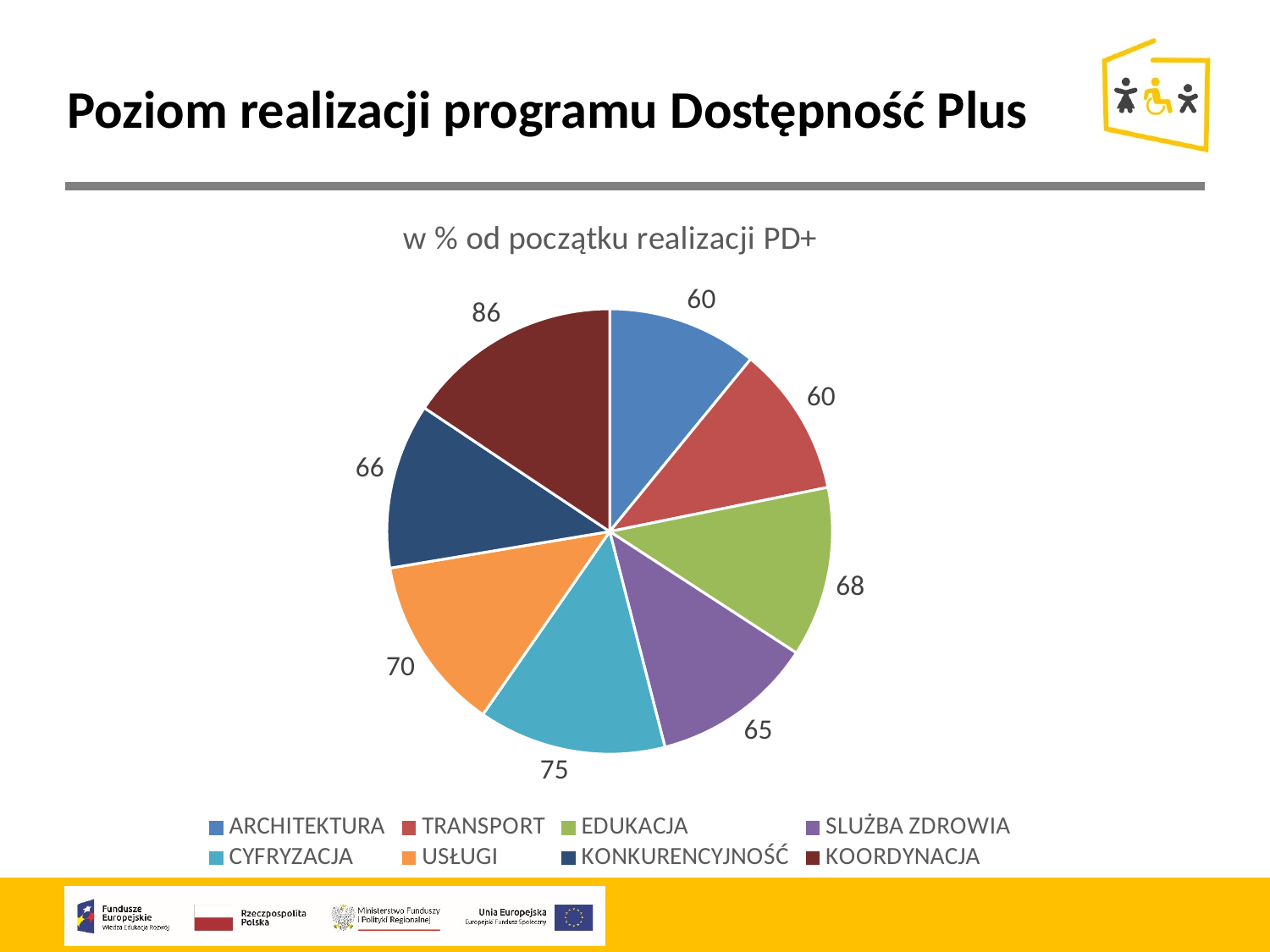
Which is larger, the value for KONKURENCYJNOŚĆ or the value for EDUKACJA? EDUKACJA What is the difference between the values for KOORDYNACJA and ARCHITEKTURA? 26 What is the value for USŁUGI in the pie chart? 70 What type of chart is shown on the slide? Pie chart What is the value for EDUKACJA in the pie chart? 68 How many slices does the pie chart have? 8 What is the value for SLUŻBA ZDROWIA in the pie chart? 65 What is the value for KOORDYNACJA in the pie chart? 86 What is the title of the chart? w % od początku realizacji PD+ What is the value for CYFRYZACJA in the pie chart? 75 What is the difference between the values for CYFRYZACJA and USŁUGI? 5 Which category has the largest slice in the pie chart? KOORDYNACJA